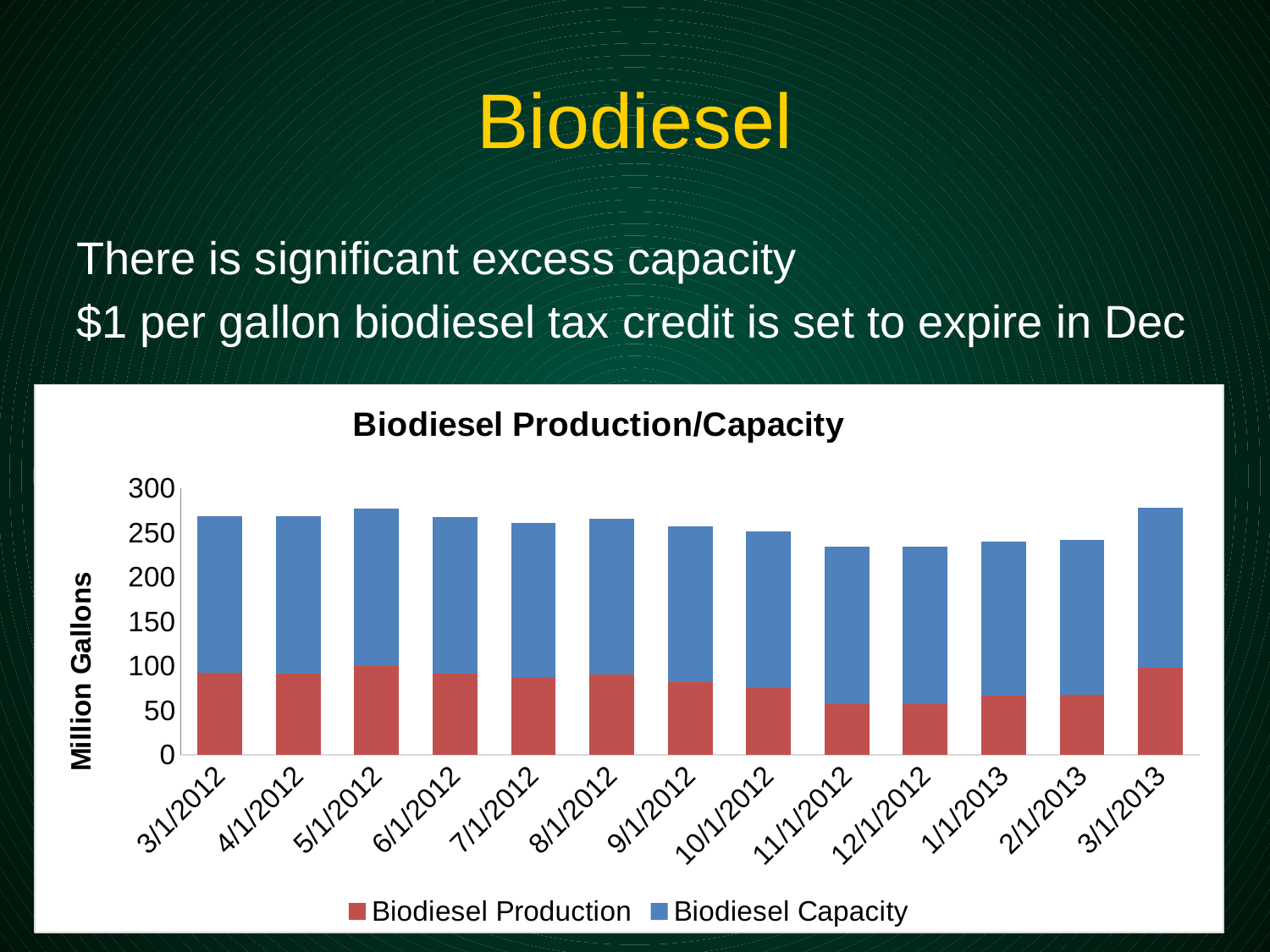
Is the Biodiesel Production value for 11/1/2012 greater or less than 100? less Is the Biodiesel Production value for 5/1/2012 greater or less than 50? greater Is the total height of the stacked bar for 3/1/2013 greater or less than 250? greater Which stacked bar is taller overall, 5/1/2012 or 12/1/2012? 5/1/2012 Does the Biodiesel Production value generally rise or fall from 6/1/2012 to 12/1/2012? fall Which has the larger Biodiesel Production value, 3/1/2012 or 11/1/2012? 3/1/2012 What is the label on the vertical axis of the chart? Million Gallons How many series does the chart's legend list? 2 What kind of chart is shown on the slide? Stacked bar chart What is the title of the chart? Biodiesel Production/Capacity How many dates are shown along the x axis of the chart? 13